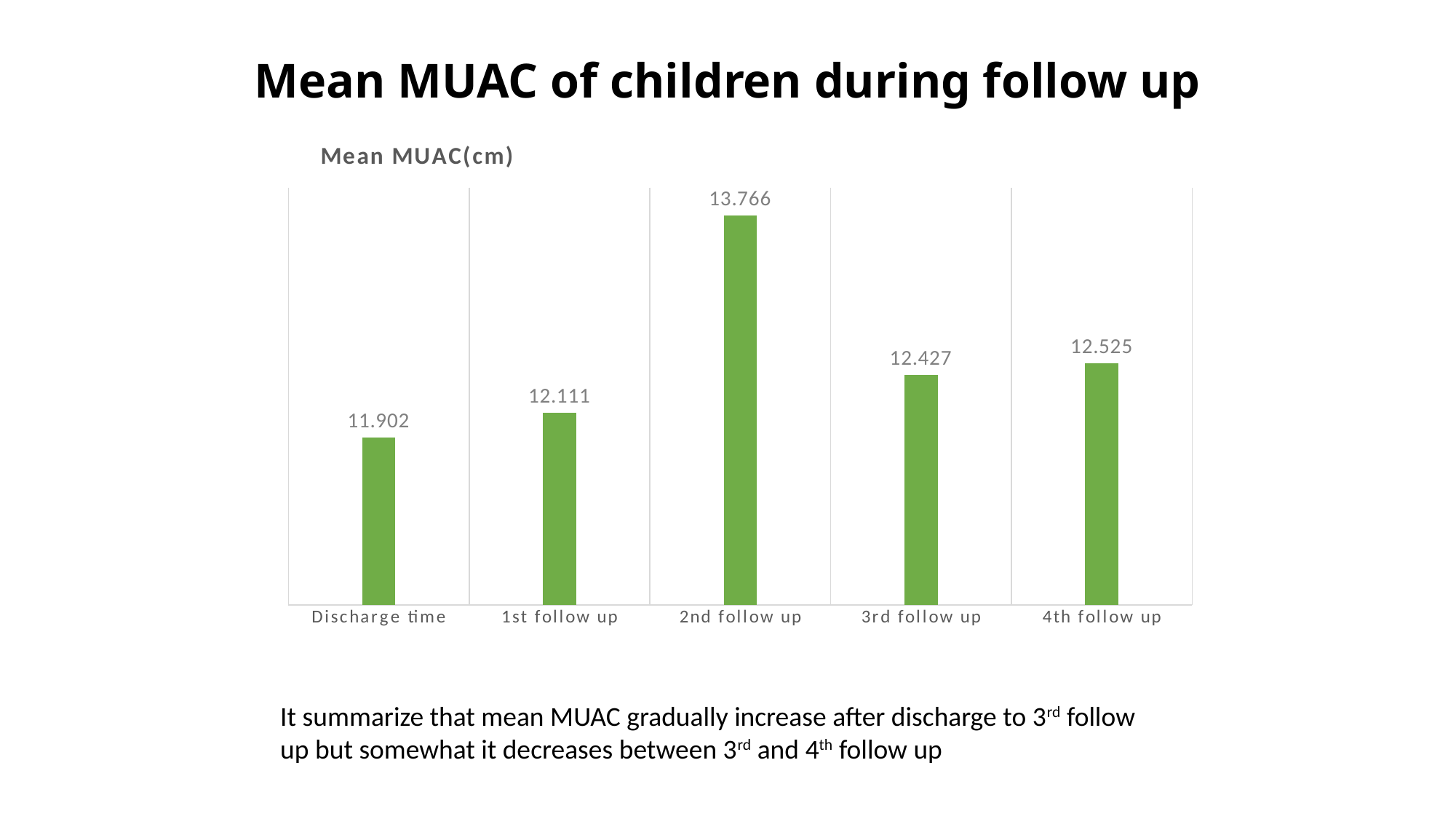
What is the mean MUAC at the 4th follow up? 12.525 What is the difference in mean MUAC between the 1st follow up and discharge time? 0.209 Which time point has the lowest mean MUAC? Discharge time What is the mean MUAC at discharge time? 11.902 Which time point has the highest mean MUAC? 2nd follow up How many time points are shown in the chart? 5 What is the difference in mean MUAC between the 2nd follow up and the 3rd follow up? 1.339 What colour are the bars in the chart? Green What is the title of the chart? Mean MUAC(cm) Which has a larger mean MUAC, the 3rd follow up or the 4th follow up? 4th follow up What is the mean MUAC at the 2nd follow up? 13.766 What kind of chart is shown on the slide? Bar chart